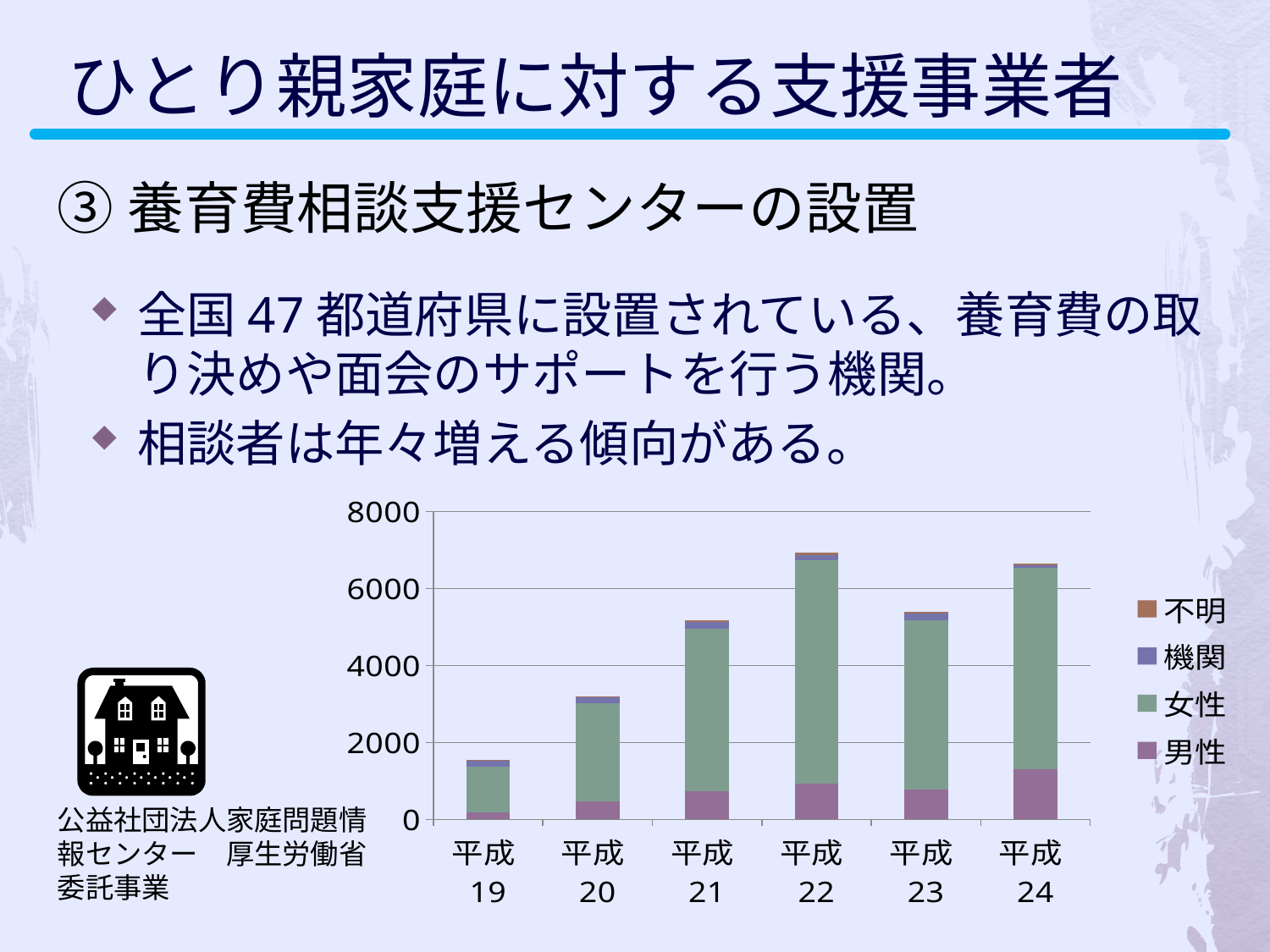
What kind of chart is shown on the slide? stacked bar chart How many years (categories) are shown on the x axis of the chart? 6 Do the stacked bar totals rise or fall from 平成19 to 平成22? rise Is the total bar height for 平成20 greater or less than 2000? greater Which year has the shortest stacked bar in the chart? 平成19 Which bar is taller, 平成20 or 平成21? 平成21 Which series makes up the largest portion of each stacked bar? 女性 Is the total bar height for 平成22 greater or less than 6000? greater Which year has the tallest stacked bar in the chart? 平成22 How many series does the chart legend list? 4 Is the total bar height for 平成23 greater or less than 6000? less